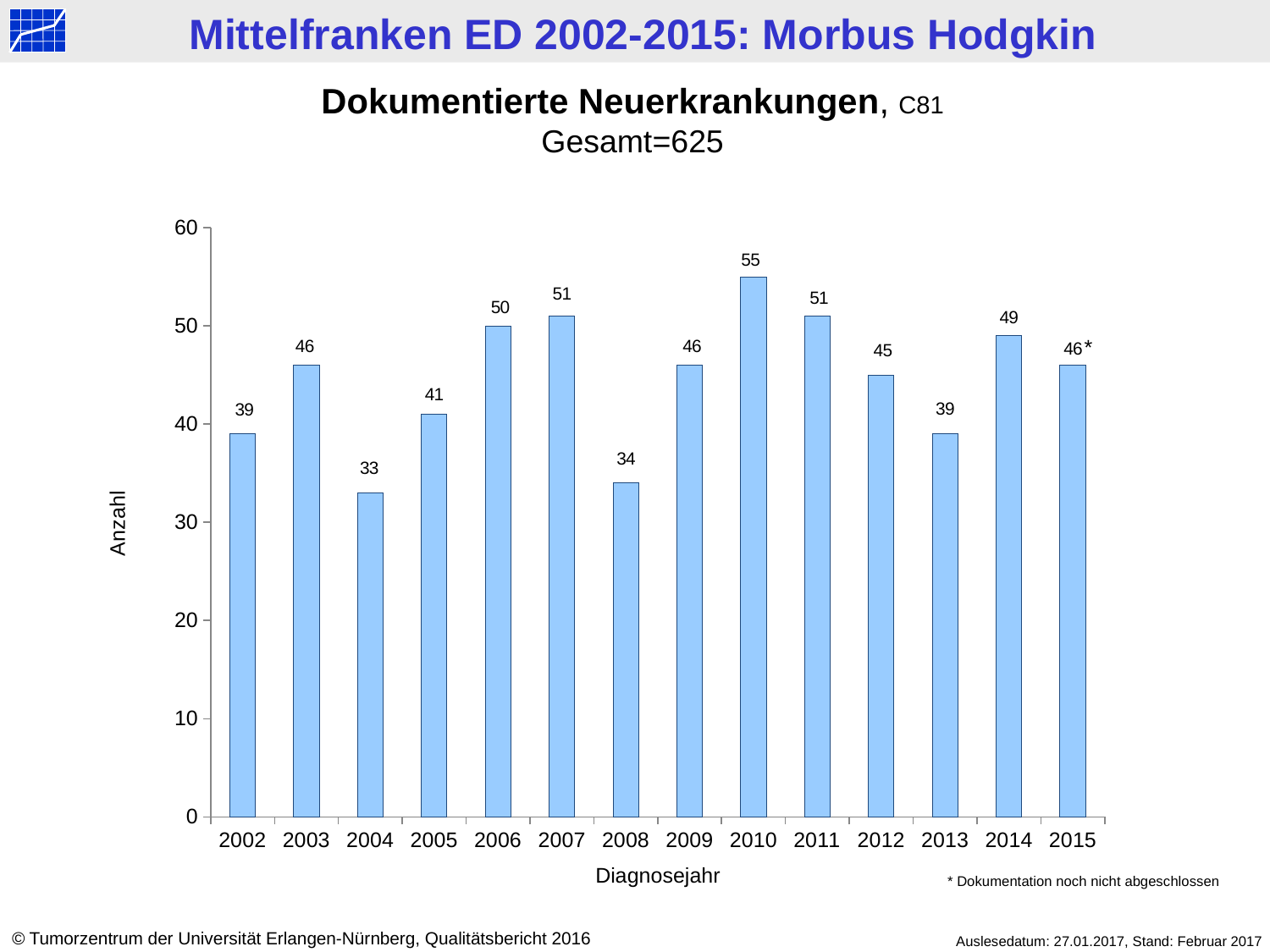
What is the difference between the values for 2010 and 2008? 21 What total (Gesamt) is stated above the chart? 625 Which year has the highest value? 2010 What is the value for 2015? 46 What is the value for 2010? 55 How many years are shown on the x axis? 14 Which year has the lowest value? 2004 What is the value for 2004? 33 What is the label of the y axis? Anzahl Is the value for 2007 greater or less than 40? greater Which is larger, the value for 2006 or the value for 2012? 2006 What kind of chart is shown? bar chart